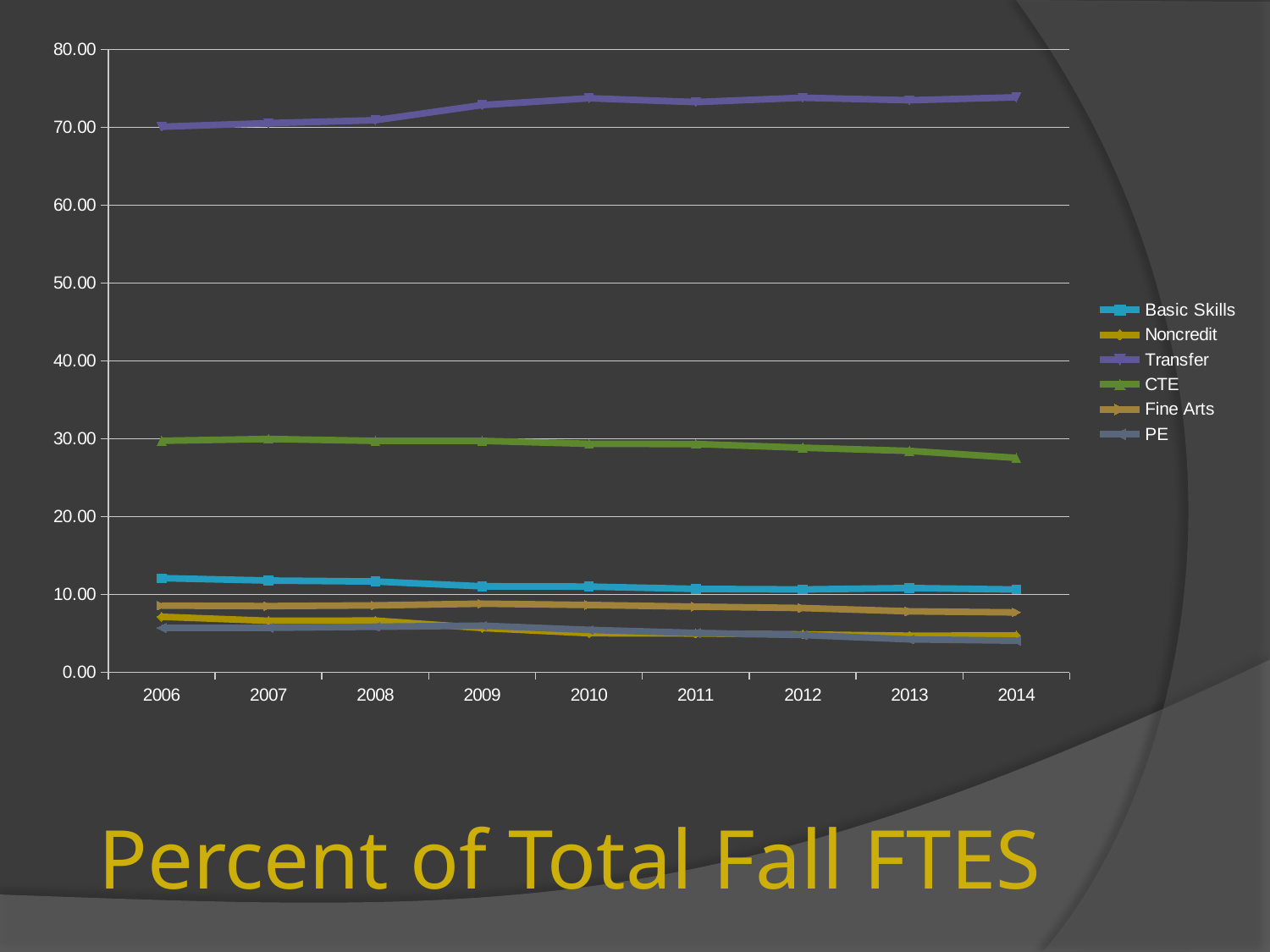
What kind of chart is shown on the slide? line chart How many series does the legend list? 6 Is the value for Transfer in 2006 greater or less than 60? greater In 2010, which is larger: Transfer or CTE? Transfer Does the Transfer series rise or fall from 2006 to 2014? rise Is the value for Fine Arts in 2014 greater or less than 10? less Is the value for CTE in 2014 greater or less than 30? less Which series has the highest values across all years? Transfer Does the CTE series rise or fall from 2007 to 2014? fall What is the title of the slide? Percent of Total Fall FTES How many years are plotted along the x axis? 9